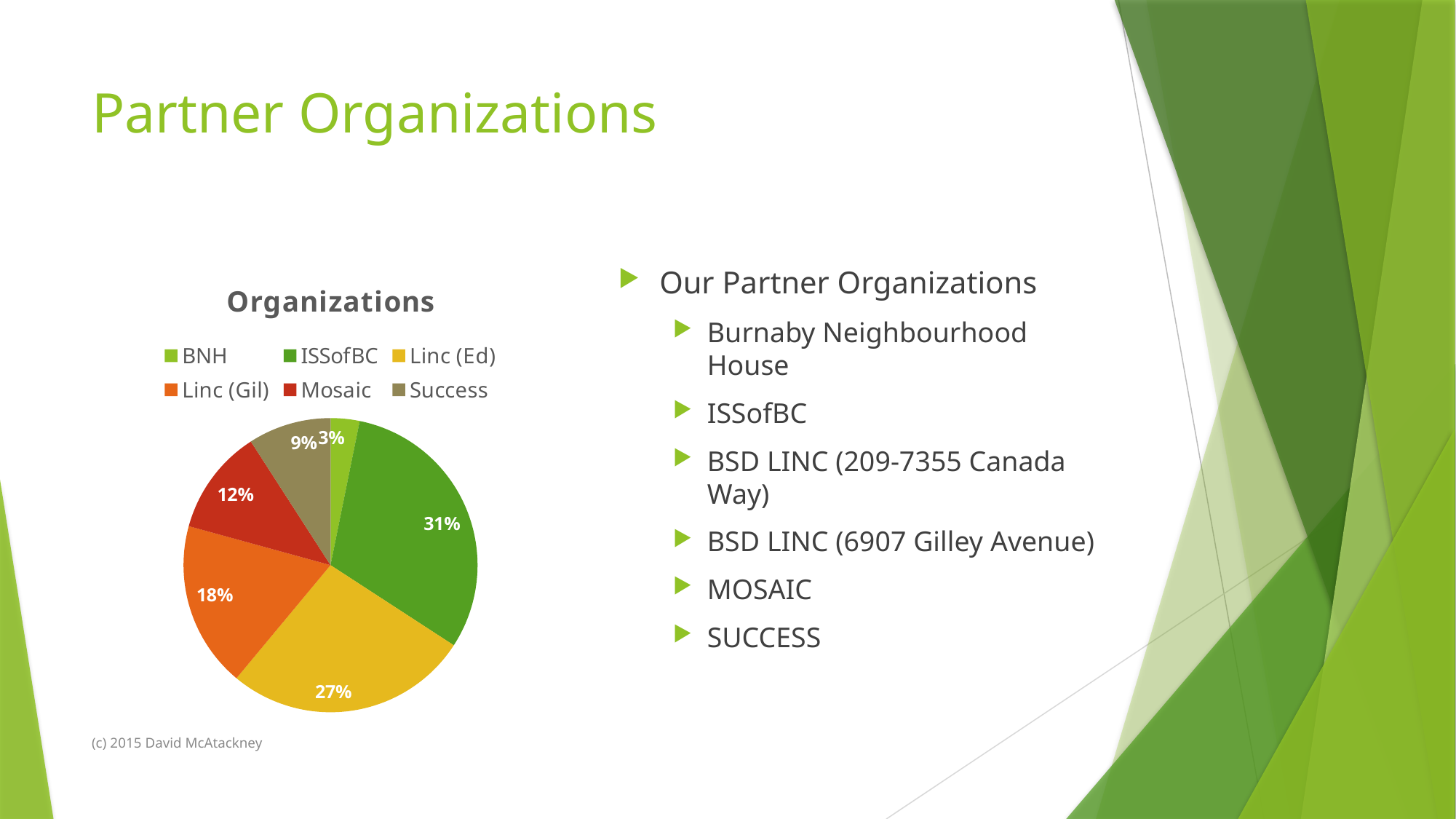
Which has a larger share, Linc (Gil) or Mosaic? Linc (Gil) What is the difference in percentage points between ISSofBC and Linc (Ed)? 4 What share of the pie does Success have? 9% Which organization has the smallest slice of the pie? BNH What type of chart is shown on the slide? pie chart What share of the pie does Linc (Ed) have? 27% How many organizations are listed in the chart legend? 6 What share of the pie does Mosaic have? 12% What share of the pie does ISSofBC have? 31% Which organization has the largest slice of the pie? ISSofBC What share of the pie does Linc (Gil) have? 18% What is the title of the chart? Organizations